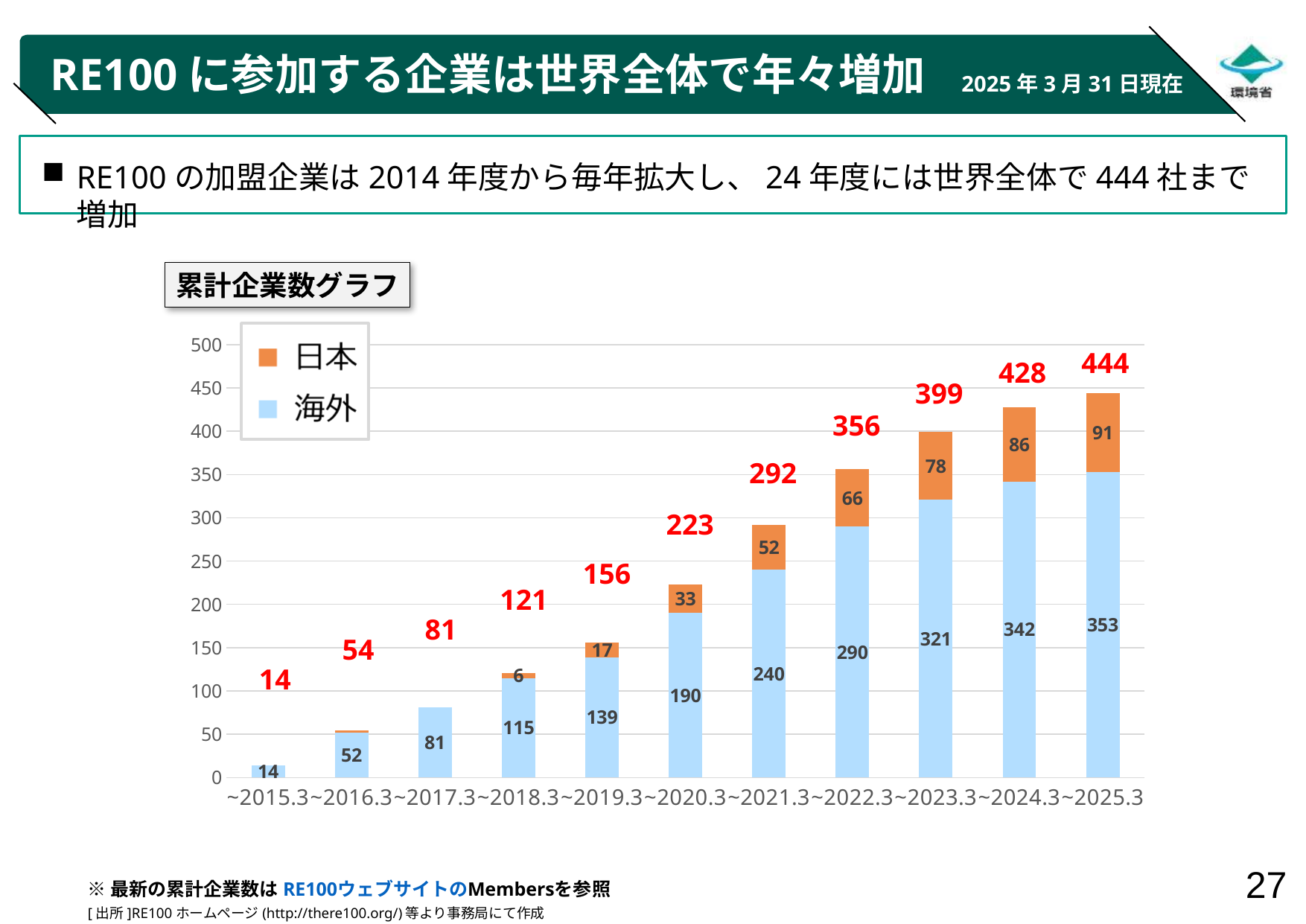
Which is larger, the 海外 value for ~2020.3 or the 海外 value for ~2019.3? ~2020.3 Which period has the highest total? ~2025.3 Which colour represents 日本 in the chart? orange Which period has the lowest total? ~2015.3 How many categories (periods) are shown on the x axis? 11 What is the 海外 value for ~2021.3? 240 What type of chart is shown on the slide? stacked bar chart What is the difference between the totals for ~2025.3 and ~2024.3? 16 What is the total number of companies shown for ~2025.3? 444 What is the 日本 value for ~2023.3? 78 Do the totals rise or fall from ~2015.3 to ~2025.3? rise How many series does the legend list? 2